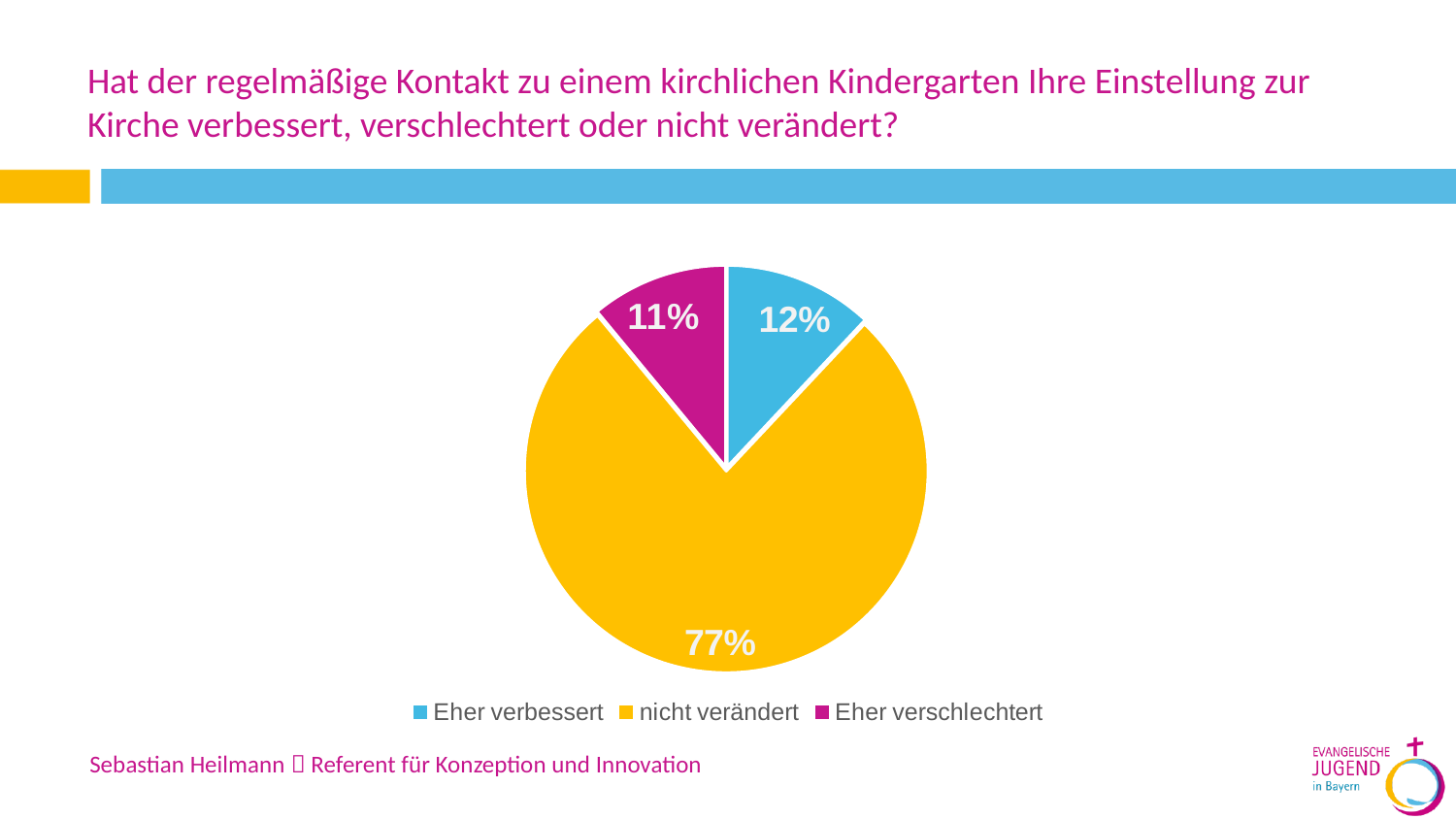
Which is larger, the slice for "Eher verbessert" or the slice for "nicht verändert"? nicht verändert How many entries does the legend list? 3 Which category has the largest slice of the pie? nicht verändert Which category has the smallest slice of the pie? Eher verschlechtert What share of the pie is labelled "Eher verschlechtert"? 11% What is the difference in percentage points between "Eher verbessert" and "Eher verschlechtert"? 1 What share of the pie is labelled "nicht verändert"? 77% What is the difference in percentage points between "nicht verändert" and "Eher verbessert"? 65 How many slices does the pie chart have? 3 What colour is the slice for "Eher verschlechtert"? magenta What share of the pie is labelled "Eher verbessert"? 12% What kind of chart is shown on the slide? pie chart